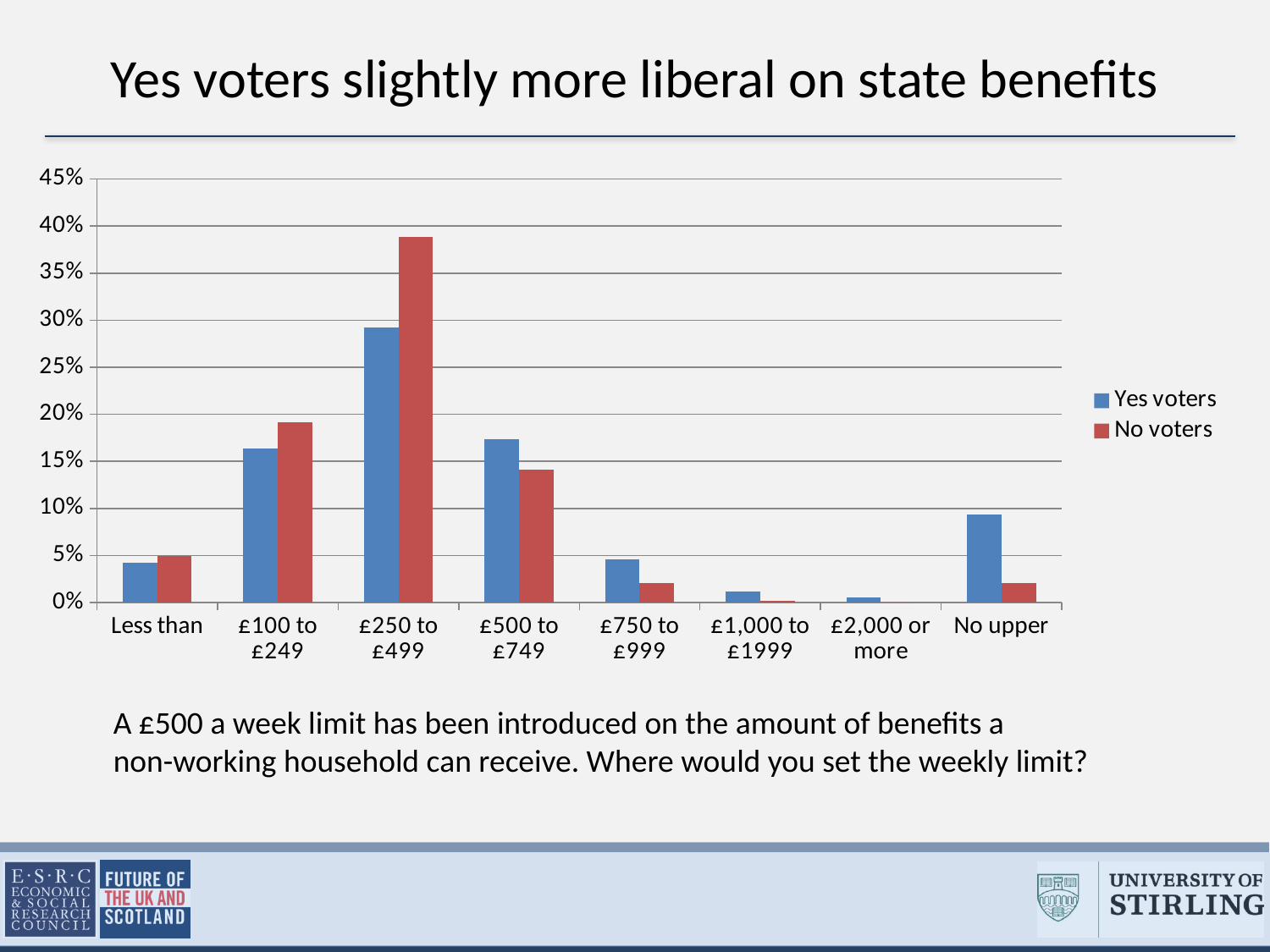
In the £250 to £499 category, which series has the larger value, Yes voters or No voters? No voters What kind of chart is shown on the slide? bar chart Which category has the highest value for No voters? £250 to £499 In the £500 to £749 category, which series has the larger value, Yes voters or No voters? Yes voters How many series does the legend list? 2 How many categories are shown along the x axis? 8 Is the value for No voters in the £250 to £499 category greater or less than 35%? greater Is the value for Yes voters in the £250 to £499 category greater or less than 25%? greater Which category has the highest value for Yes voters? £250 to £499 What colour are the bars for Yes voters? blue In the No upper category, which series has the larger value, Yes voters or No voters? Yes voters